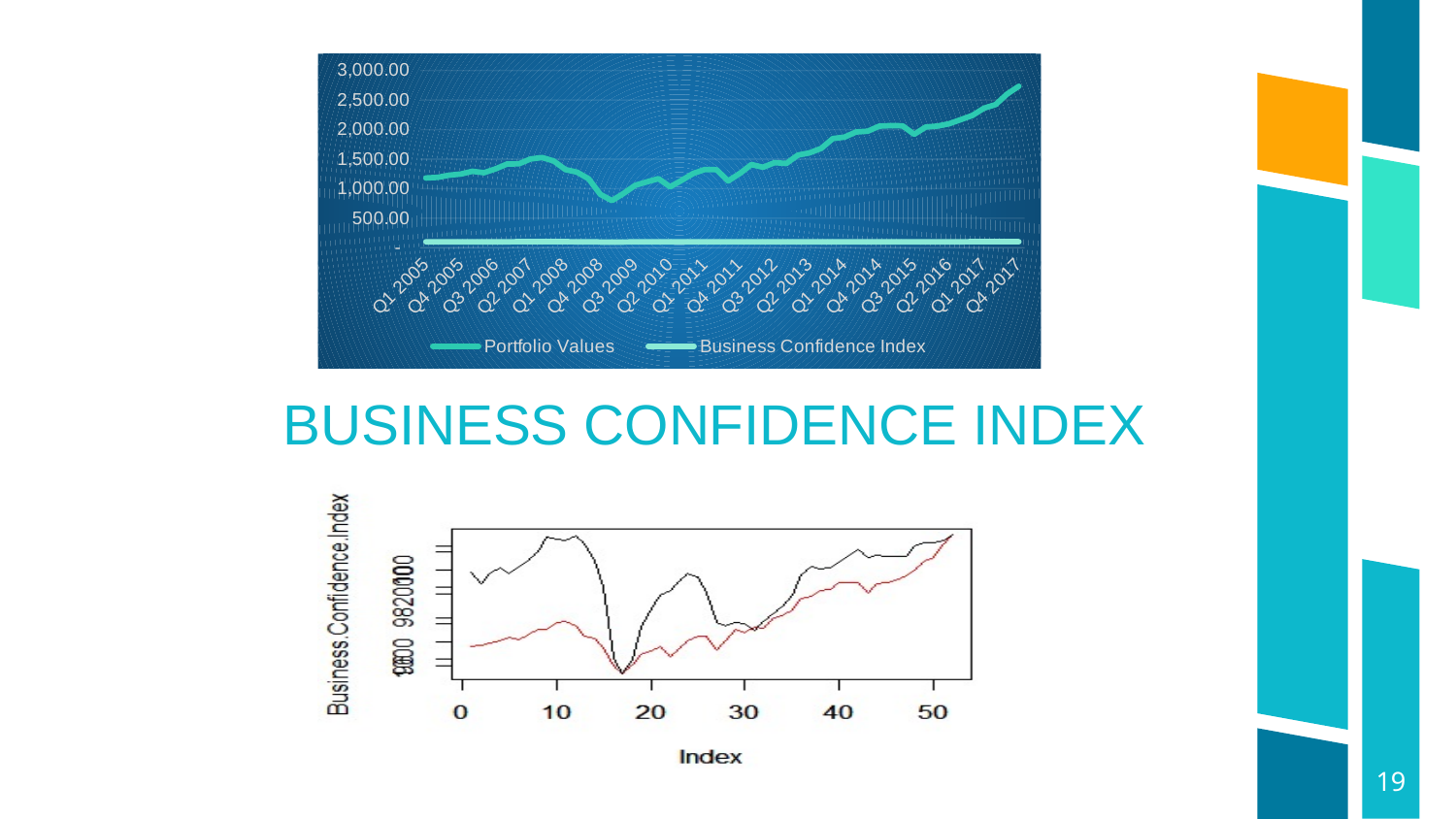
In the top chart, which series is larger at Q2 2013, Portfolio Values or Business Confidence Index? Portfolio Values In the top chart, does the Portfolio Values line rise or fall between Q1 2014 and Q4 2017? rise In the top chart, what are the two series named in the legend? Portfolio Values and Business Confidence Index In the bottom chart, what kind of chart is shown? line chart In the top chart, what kind of chart is shown? line chart In the top chart, how many series does the legend list? 2 In the bottom chart, what is the label of the x axis? Index In the top chart, is the value for Portfolio Values at Q4 2017 greater or less than 2,500.00? greater In the top chart, what is the first category label on the x axis? Q1 2005 In the top chart, is the value for Business Confidence Index at Q1 2011 greater or less than 500.00? less In the top chart, is the value for Portfolio Values at Q1 2005 greater or less than 1,500.00? less